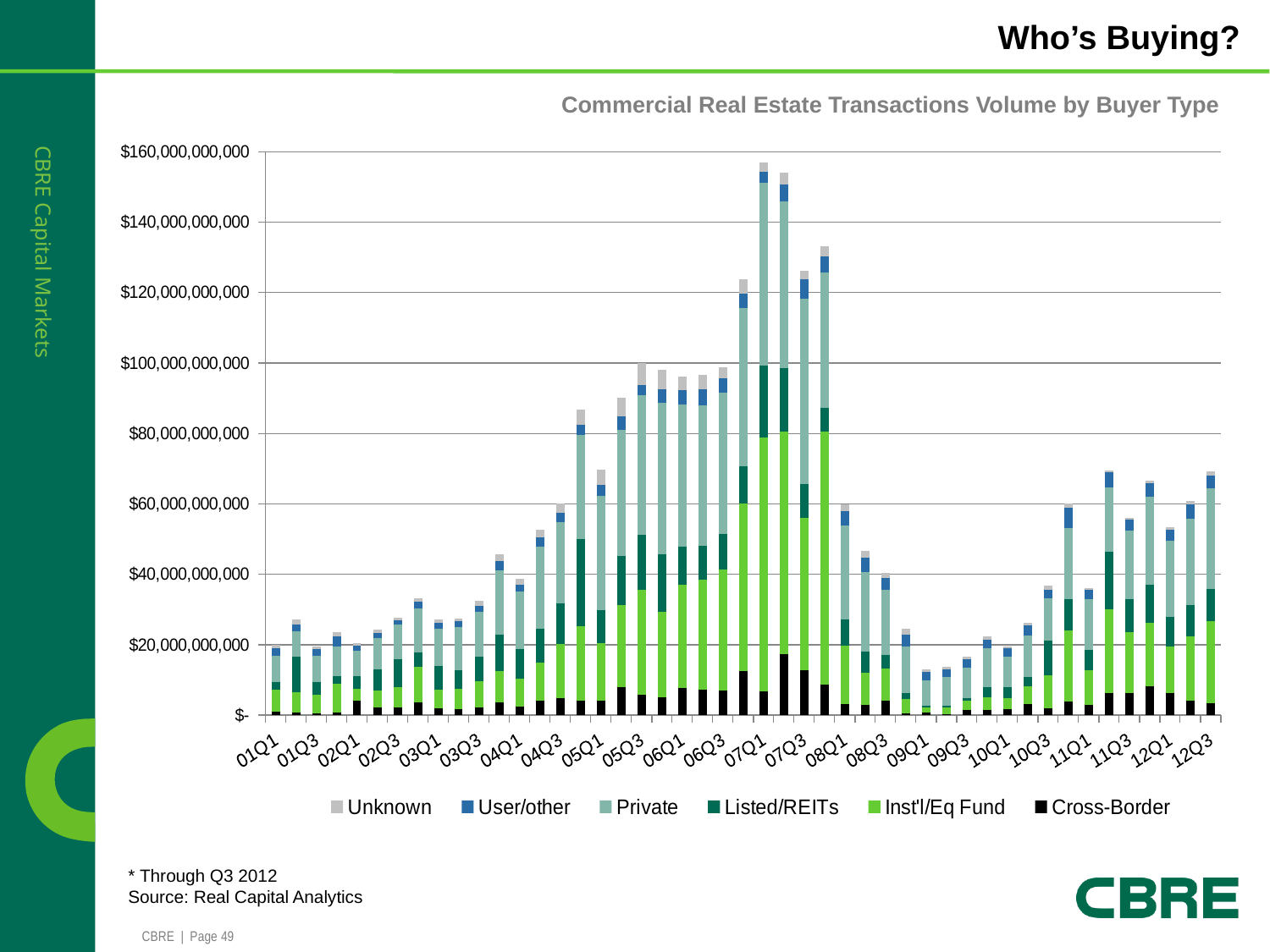
Which quarter has the highest total transaction volume? 07Q1 Do total transaction volumes rise or fall from 07Q1 to 09Q1? fall What kind of chart is shown on the slide? Stacked bar chart Is the total value for 07Q1 greater or less than $140,000,000,000? greater What is the title of the chart? Commercial Real Estate Transactions Volume by Buyer Type Is the total value for 03Q1 greater or less than $20,000,000,000? greater Which quarter has the lowest total transaction volume? 09Q1 How many series does the legend list? 6 Is the total value for 09Q1 greater or less than $20,000,000,000? less Which quarter has a larger total transaction volume, 07Q1 or 08Q1? 07Q1 Which buyer type is shown in black in the legend? Cross-Border